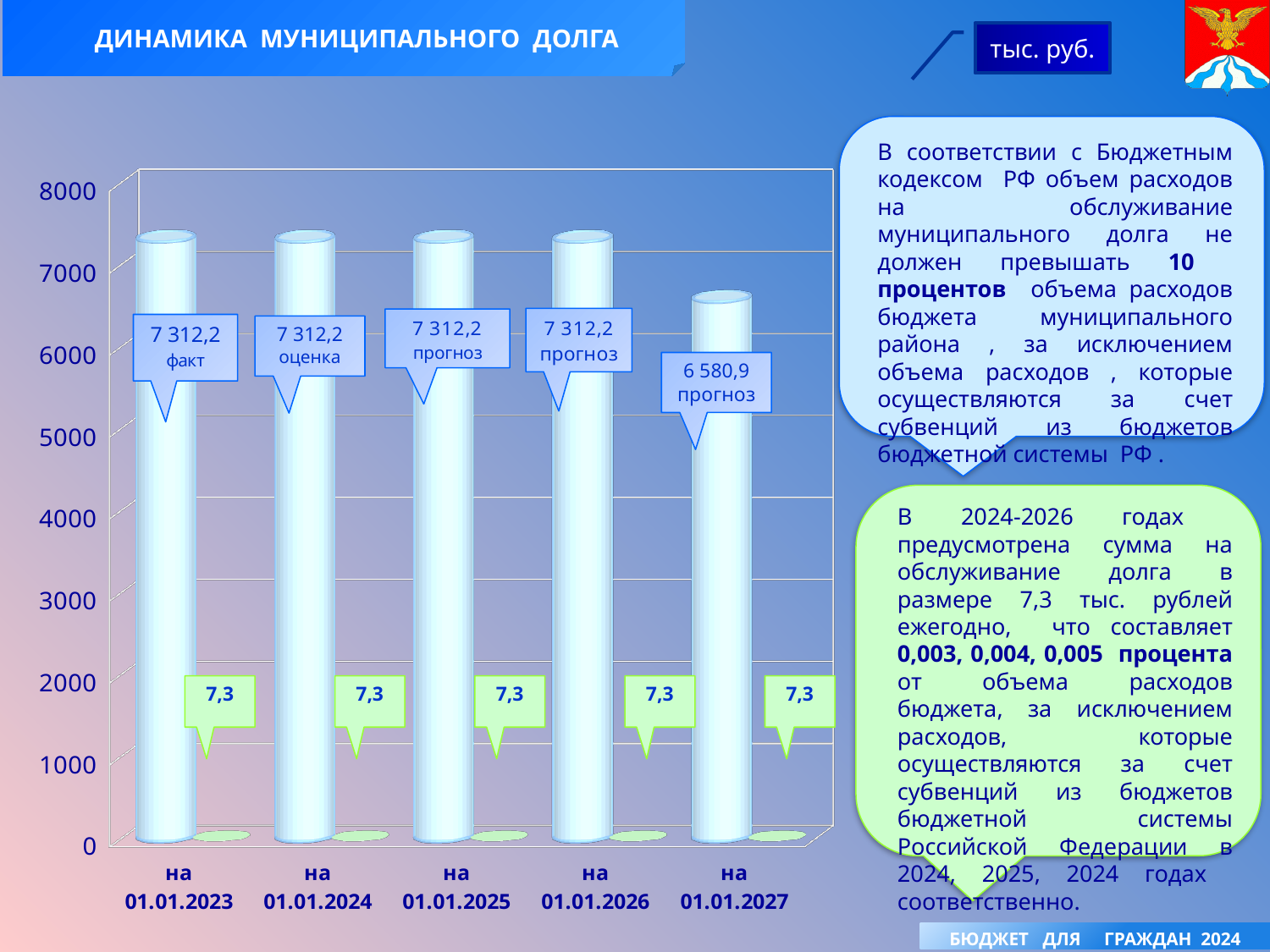
What unit of measurement is indicated for the chart values? тыс. руб. What kind of chart is shown on the slide? bar chart What is the title of the chart? ДИНАМИКА МУНИЦИПАЛЬНОГО ДОЛГА What is the municipal debt value shown for на 01.01.2027? 6 580,9 What is the debt servicing value (green label) shown for на 01.01.2025? 7,3 Do the municipal debt values rise or fall from 01.01.2026 to 01.01.2027? fall Which is larger: the municipal debt on 01.01.2024 or on 01.01.2027? 01.01.2024 How many dates (categories) are shown on the x axis? 5 What is the difference between the municipal debt on 01.01.2026 and on 01.01.2027? 731,3 Which date has the lowest municipal debt value? на 01.01.2027 What is the municipal debt value shown for на 01.01.2023? 7 312,2 Is the municipal debt value for на 01.01.2027 greater or less than 7000? less